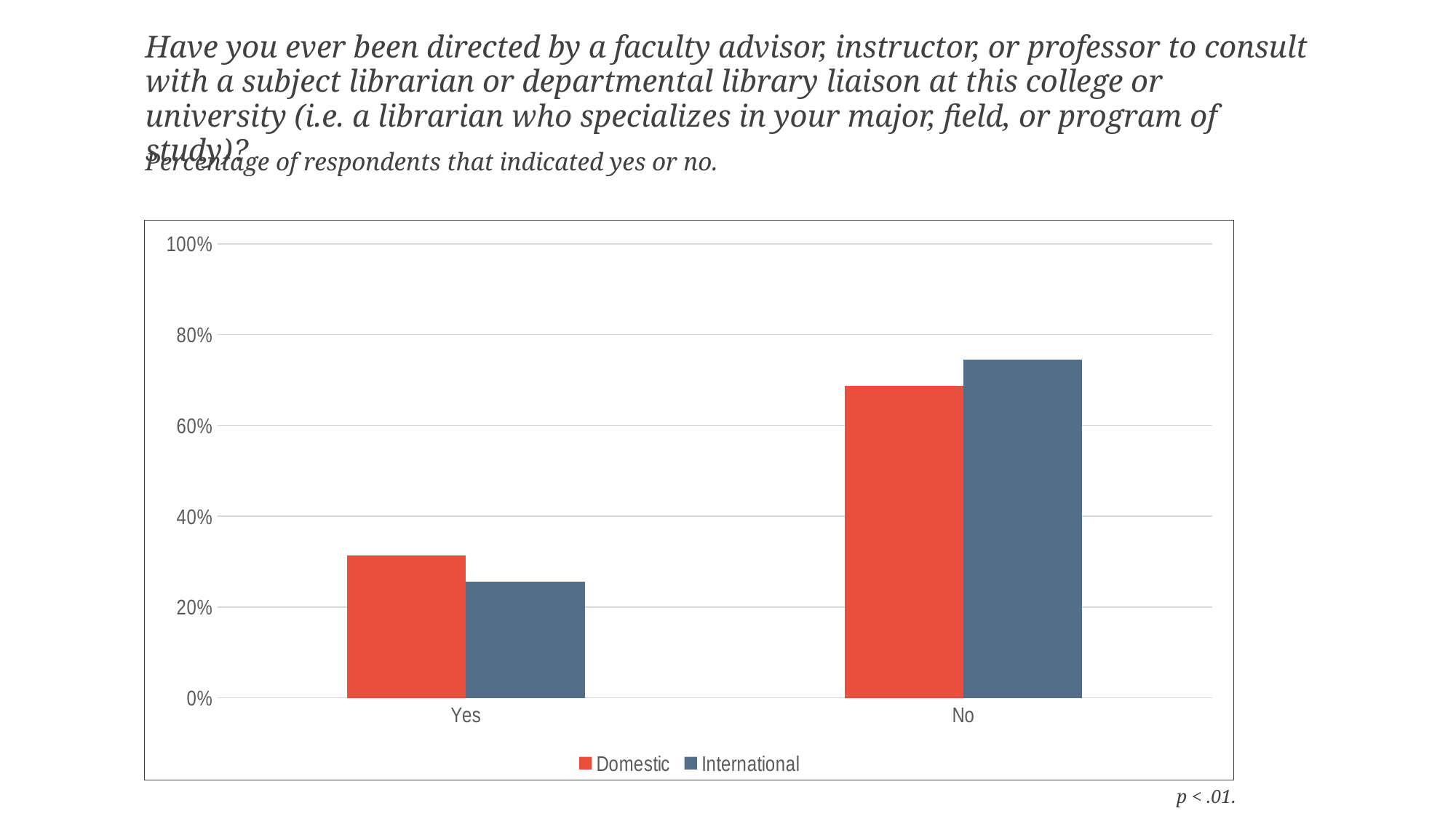
Is the International value for Yes greater or less than 20%? greater Is the Domestic value for Yes greater or less than 40%? less For the No category, which is larger: Domestic or International? International Which bar is the tallest in the chart? International, No Which series is shown in red? Domestic Is the Domestic value for No greater or less than 60%? greater How many series does the legend list? 2 Which bar is the shortest in the chart? International, Yes What kind of chart is shown on the slide? bar chart How many categories are shown on the x axis? 2 For the Yes category, which is larger: Domestic or International? Domestic